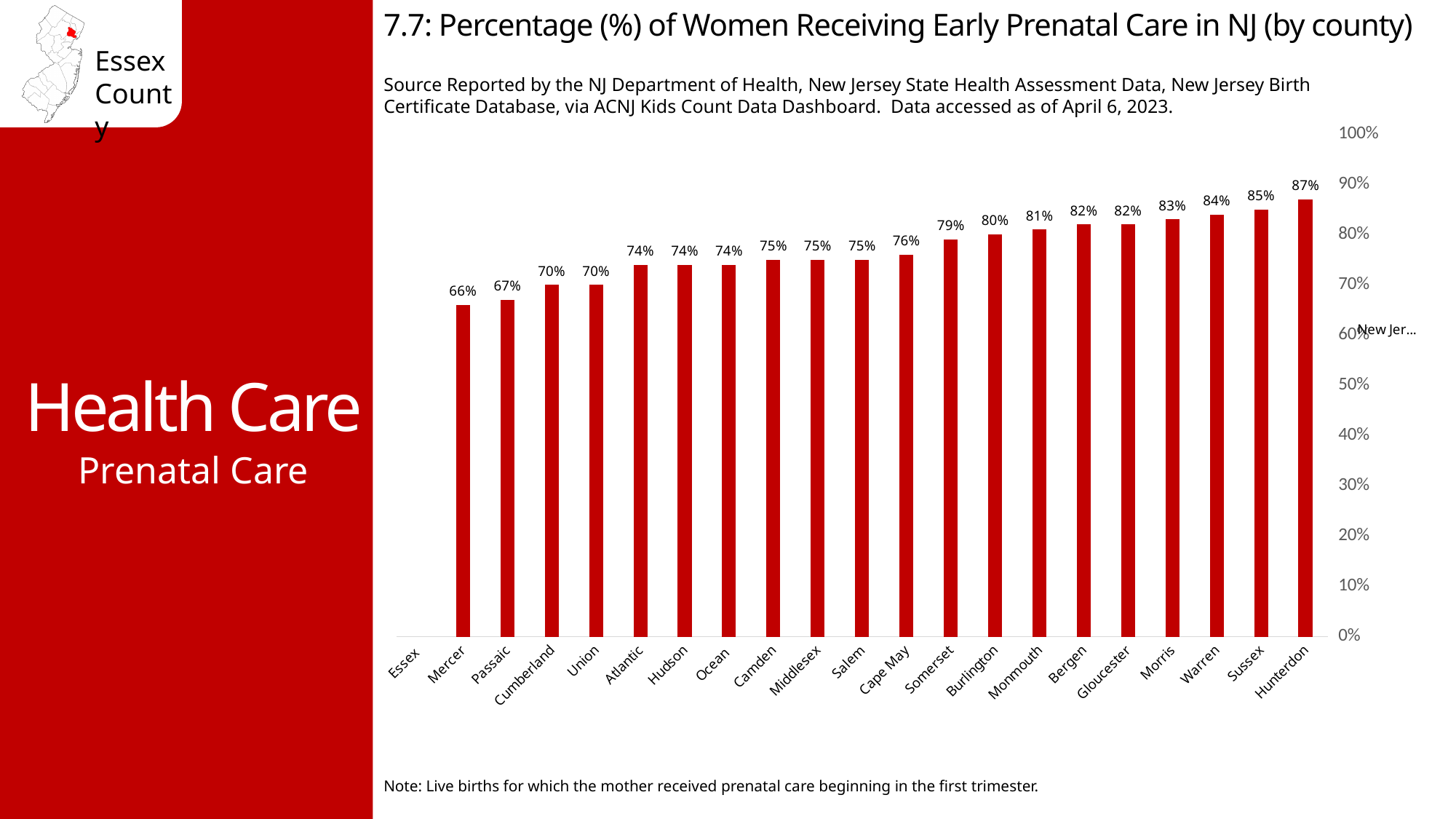
Which county has the highest percentage of women receiving early prenatal care? Hunterdon What kind of chart is shown on the slide? bar chart What is the percentage of women receiving early prenatal care in Warren? 84% What is the title of the chart? 7.7: Percentage (%) of Women Receiving Early Prenatal Care in NJ (by county) What is the percentage of women receiving early prenatal care in Mercer? 66% What is the percentage of women receiving early prenatal care in Hunterdon? 87% What is the difference in percentage points between Hunterdon and Mercer? 21 Is the value for Burlington greater or less than 70%? greater Which county has a higher percentage, Bergen or Cape May? Bergen Do the values rise or fall moving from left to right along the x axis? rise How many counties are listed along the x axis? 21 What is the percentage of women receiving early prenatal care in Somerset? 79%